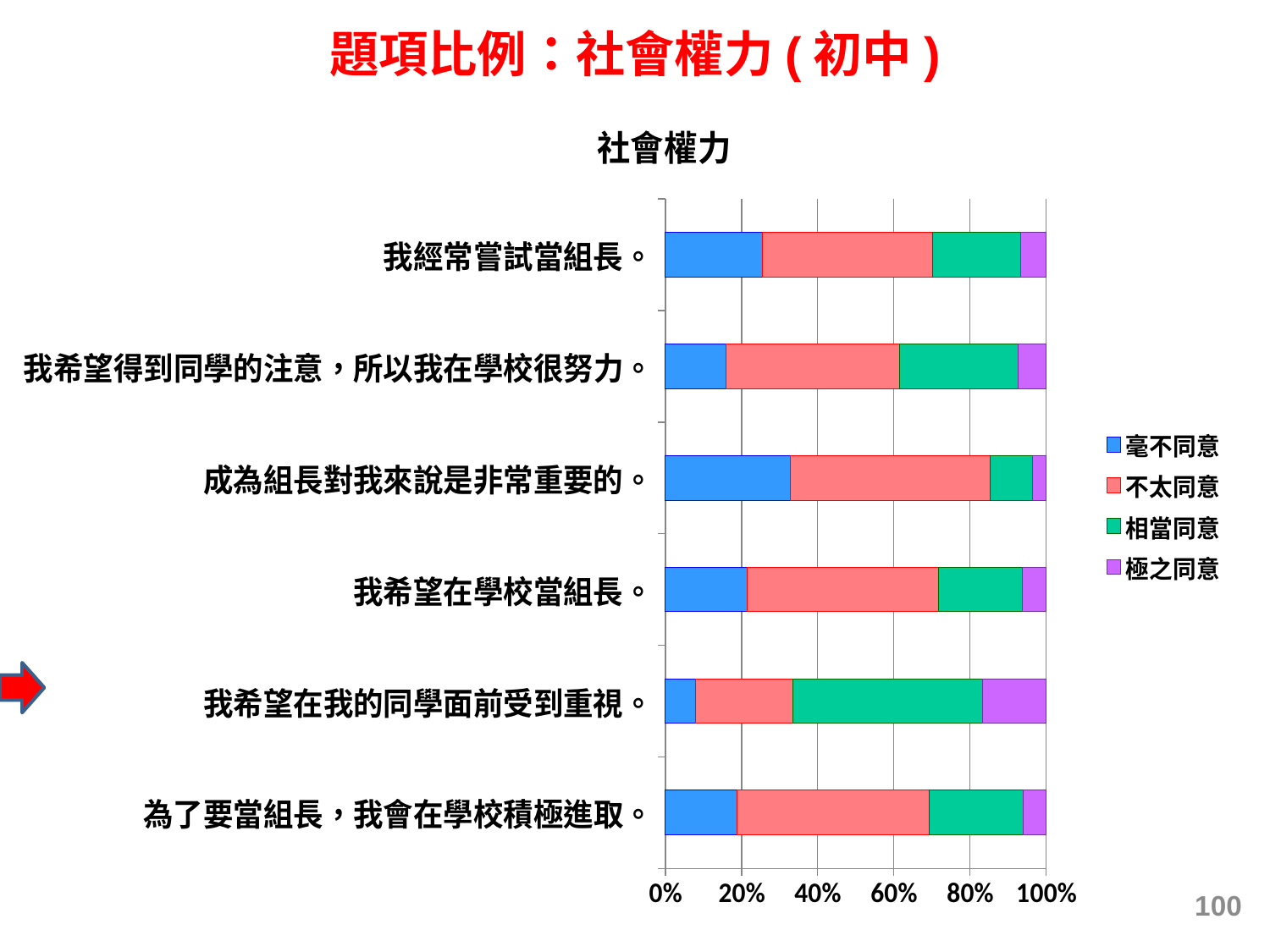
Which statement has the largest 相當同意 segment? 我希望在我的同學面前受到重視。 Which statement has the largest 極之同意 segment? 我希望在我的同學面前受到重視。 How many statements (categories) are plotted on the chart? 6 Which statement has the smallest 毫不同意 segment? 我希望在我的同學面前受到重視。 Is the 毫不同意 share for 成為組長對我來說是非常重要的。 greater or less than 20%? greater How many series does the legend list? 4 What is the title of the chart? 社會權力 Is the 毫不同意 share for 我希望在我的同學面前受到重視。 greater or less than 20%? less Which statement has the largest 毫不同意 segment? 成為組長對我來說是非常重要的。 Which has the larger 毫不同意 share: 我經常嘗試當組長。 or 我希望得到同學的注意，所以我在學校很努力。? 我經常嘗試當組長。 Which series is shown in blue according to the legend? 毫不同意 What kind of chart is shown on the slide? stacked bar chart